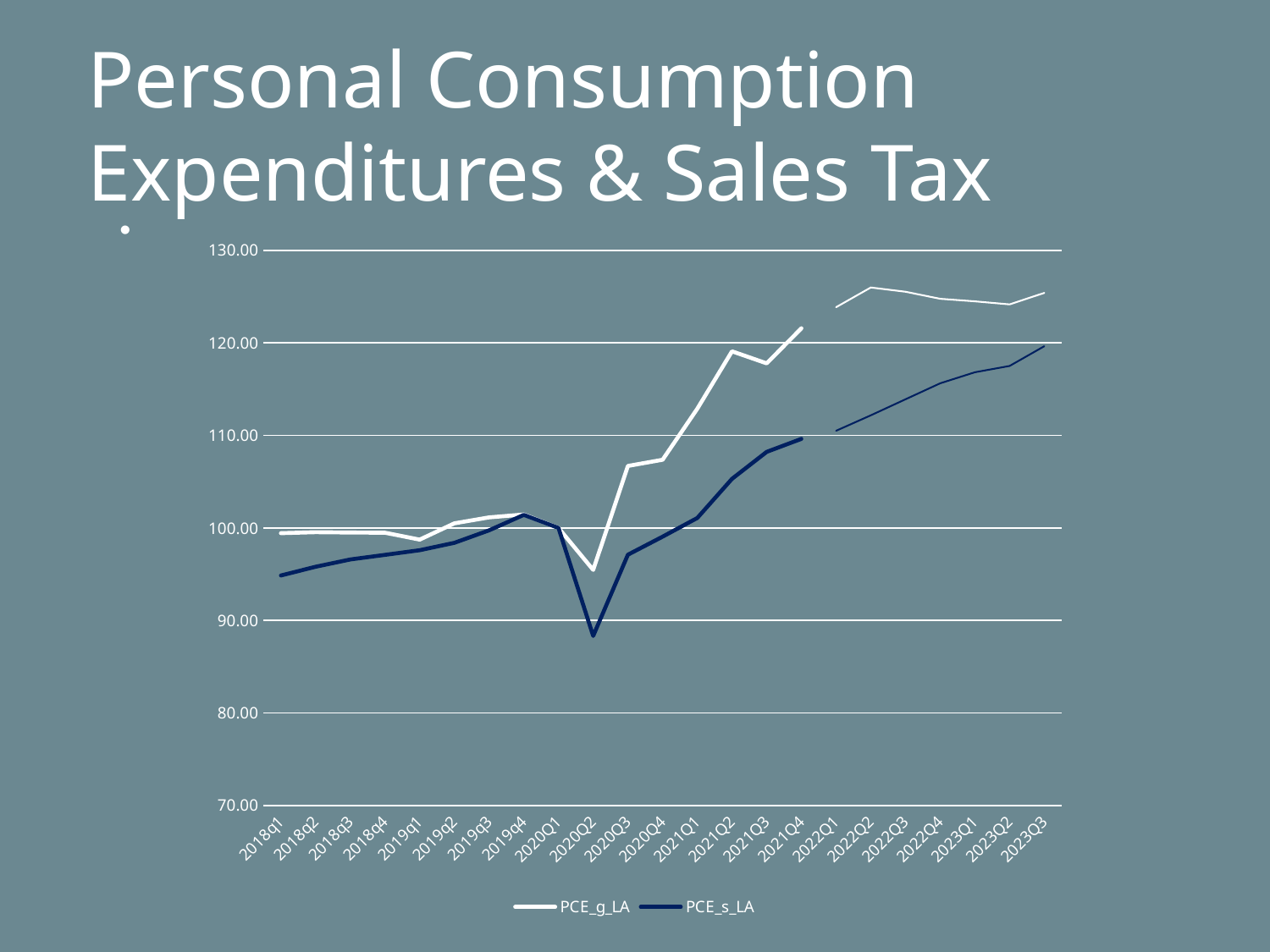
Is the value for PCE_s_LA at 2018q1 greater or less than 100.00? less How many quarters are plotted along the x axis? 23 At which quarter does PCE_g_LA reach its highest value? 2022Q2 Does PCE_s_LA rise or fall from 2022Q1 to 2023Q3? Rise At which quarter does PCE_s_LA reach its lowest value? 2020Q2 Is the value for PCE_g_LA at 2021Q2 greater or less than 110.00? greater Which series is drawn with the dark navy line? PCE_s_LA Is the value for PCE_g_LA at 2022Q2 greater or less than 120.00? greater What kind of chart is shown on the slide? Line chart At 2021Q2, which series has the larger value, PCE_g_LA or PCE_s_LA? PCE_g_LA How many series does the legend list? 2